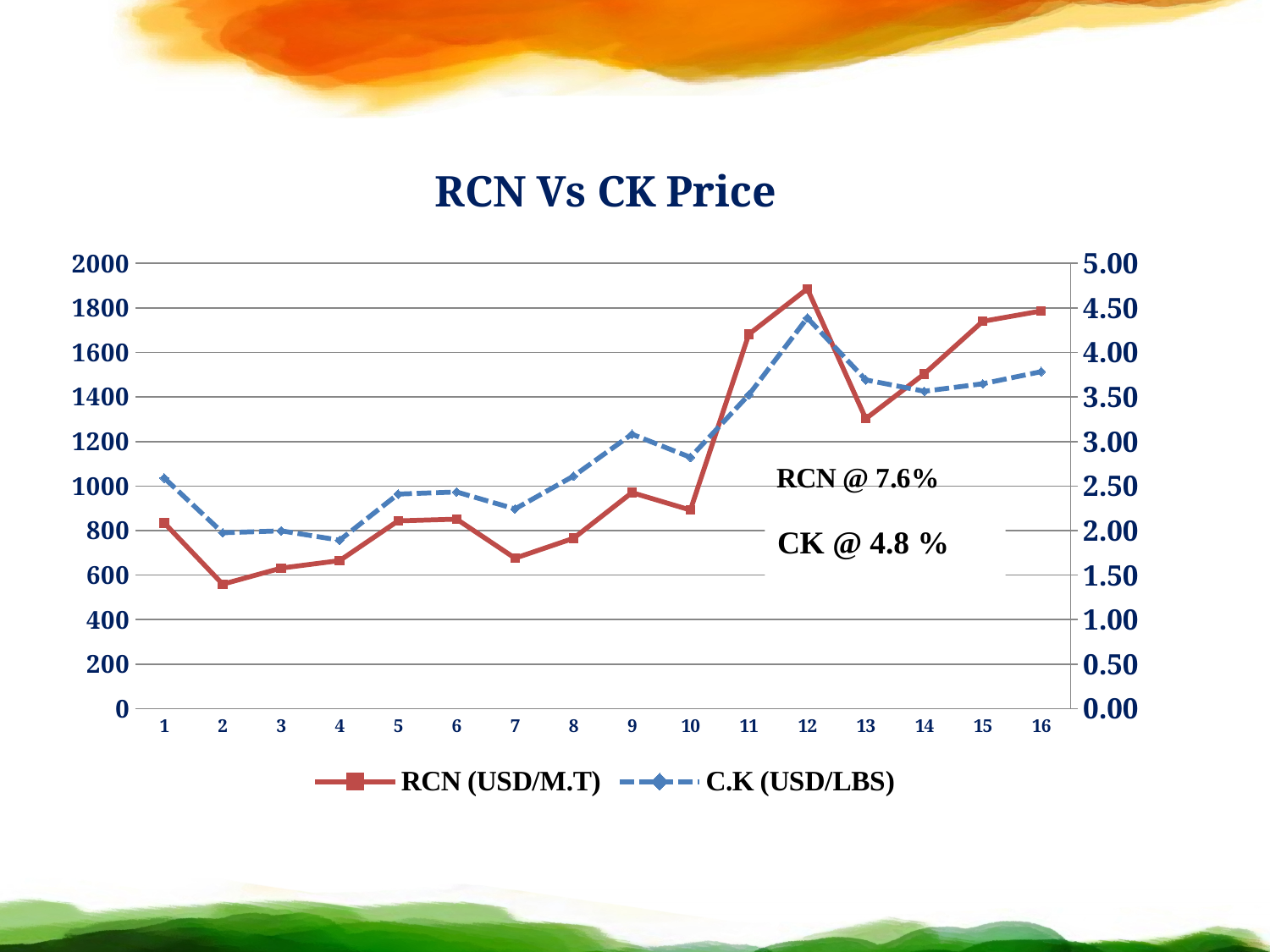
What is the title of the chart? RCN Vs CK Price How many points are plotted along the x axis for each series? 16 At which x-axis point does RCN (USD/M.T) reach its lowest value? 2 Is the value for RCN (USD/M.T) at point 12 greater or less than 1800? greater Is the value for RCN (USD/M.T) at point 2 greater or less than 600? less How many series does the legend list? 2 What kind of chart is shown on the slide? line chart At which x-axis point does RCN (USD/M.T) reach its highest value? 12 At which x-axis point does C.K (USD/LBS) reach its highest value? 12 Is the value for C.K (USD/LBS) at point 12 greater or less than 4.00? greater Does RCN (USD/M.T) rise or fall from point 1 to point 2? fall Which is larger, RCN (USD/M.T) at point 16 or RCN (USD/M.T) at point 13? point 16